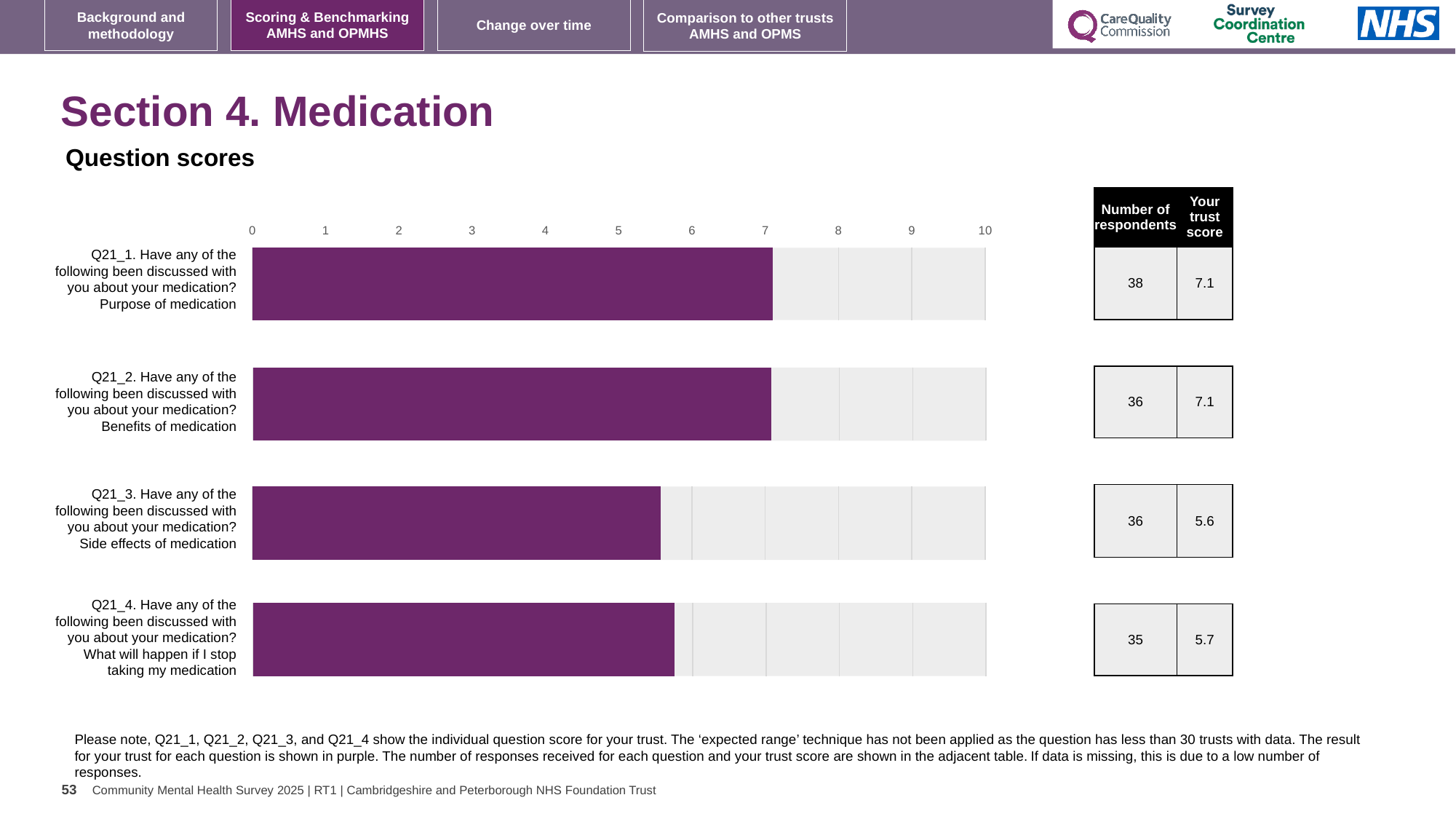
Is the trust score for Q21_3 (Side effects of medication) greater or less than 7? less What is the trust score for Q21_1 (Purpose of medication)? 7.1 What is the difference between the trust scores for Q21_1 (Purpose of medication) and Q21_3 (Side effects of medication)? 1.5 What is the trust score for Q21_4 (What will happen if I stop taking my medication)? 5.7 What kind of chart is shown on the slide? bar chart How many respondents answered Q21_4 (What will happen if I stop taking my medication)? 35 Which has the higher trust score, Q21_2 (Benefits of medication) or Q21_4 (What will happen if I stop taking my medication)? Q21_2 (Benefits of medication) What is the trust score for Q21_3 (Side effects of medication)? 5.6 Is the trust score for Q21_1 (Purpose of medication) greater or less than 5? greater How many questions are plotted in the chart? 4 How many respondents answered Q21_1 (Purpose of medication)? 38 What is the maximum value shown on the chart's axis? 10